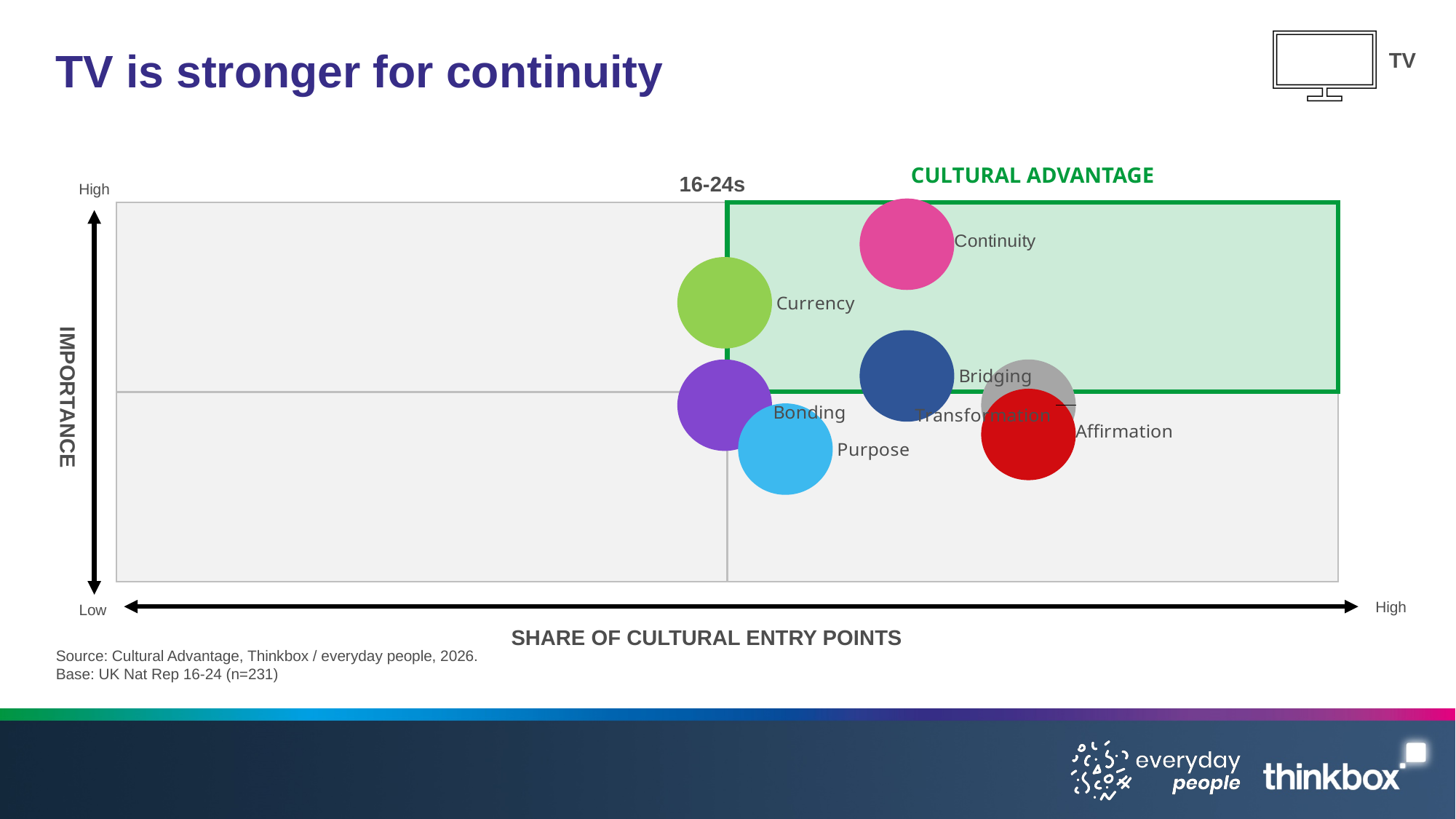
Which bubble has the highest importance? Continuity What is the label of the vertical axis? IMPORTANCE What is the sample size (n) given in the base note? 231 What kind of chart is shown on the slide? Bubble chart Which age group does the chart cover, as labelled above the chart? 16-24s Which has higher importance, Continuity or Purpose? Continuity What is the label of the horizontal axis? SHARE OF CULTURAL ENTRY POINTS What is the name of the green shaded zone in the top-right of the chart? CULTURAL ADVANTAGE Which has higher importance, Continuity or Currency? Continuity Which has a higher share of cultural entry points, Currency or Affirmation? Affirmation How many bubbles are plotted on the chart? 7 Which bubble has the lowest importance? Purpose